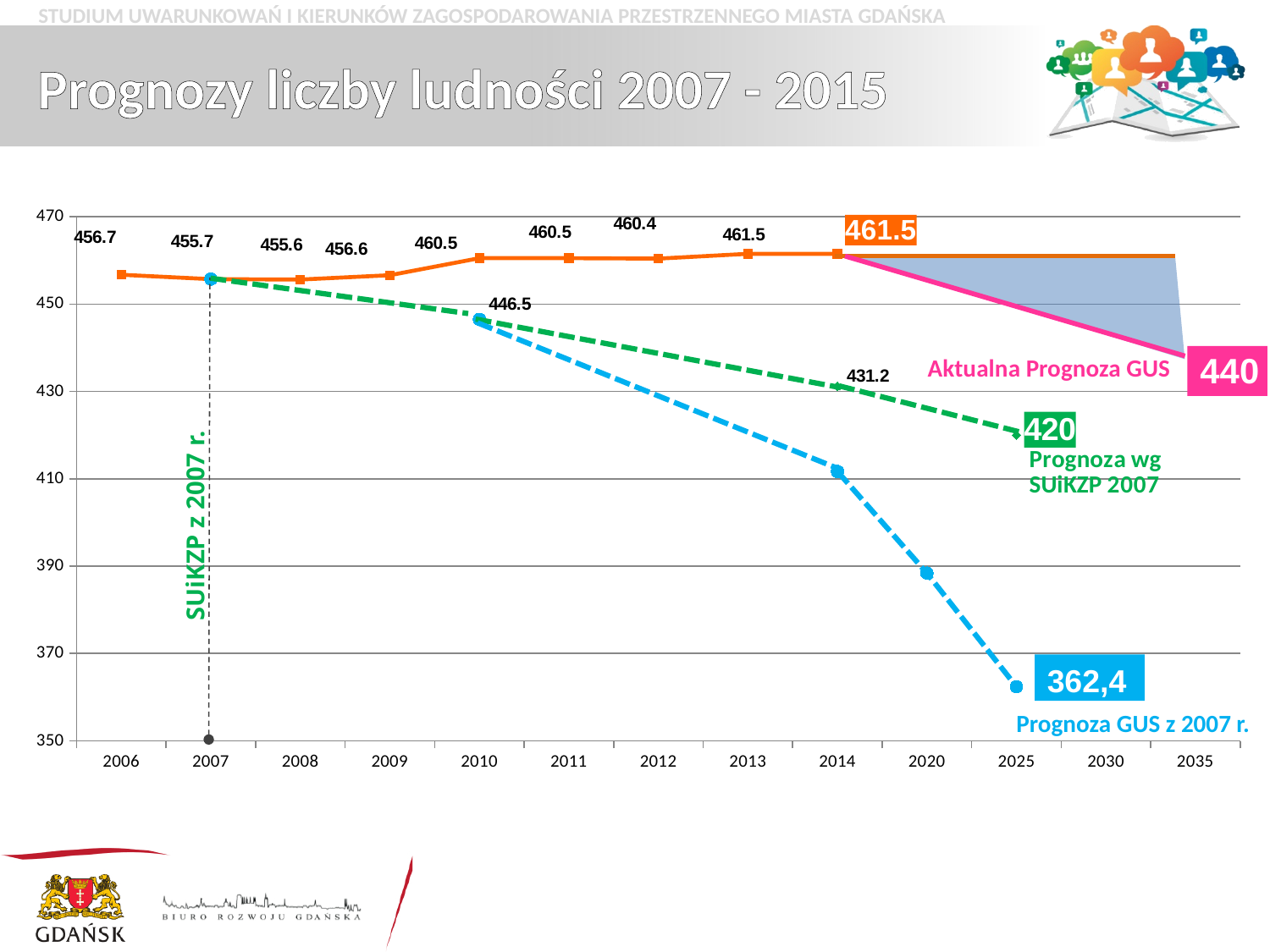
What type of chart is shown on the slide? line chart What value does the Prognoza GUS z 2007 r. line reach in 2025? 362,4 What value does the Prognoza wg SUiKZP 2007 line reach in 2025? 420 What value does the Prognoza wg SUiKZP 2007 line show for 2010? 446.5 What is the value of the orange line for 2012? 460.4 Which forecast line is lower in 2025: Prognoza wg SUiKZP 2007 or Prognoza GUS z 2007 r.? Prognoza GUS z 2007 r. What is the value of the orange line for 2013? 461.5 What is the value of the orange line for 2006? 456.7 What value does the Prognoza wg SUiKZP 2007 line show for 2014? 431.2 What value does the Aktualna Prognoza GUS line reach in 2035? 440 What is the difference between the orange line's value for 2013 (461.5) and its value for 2006 (456.7)? 4.8